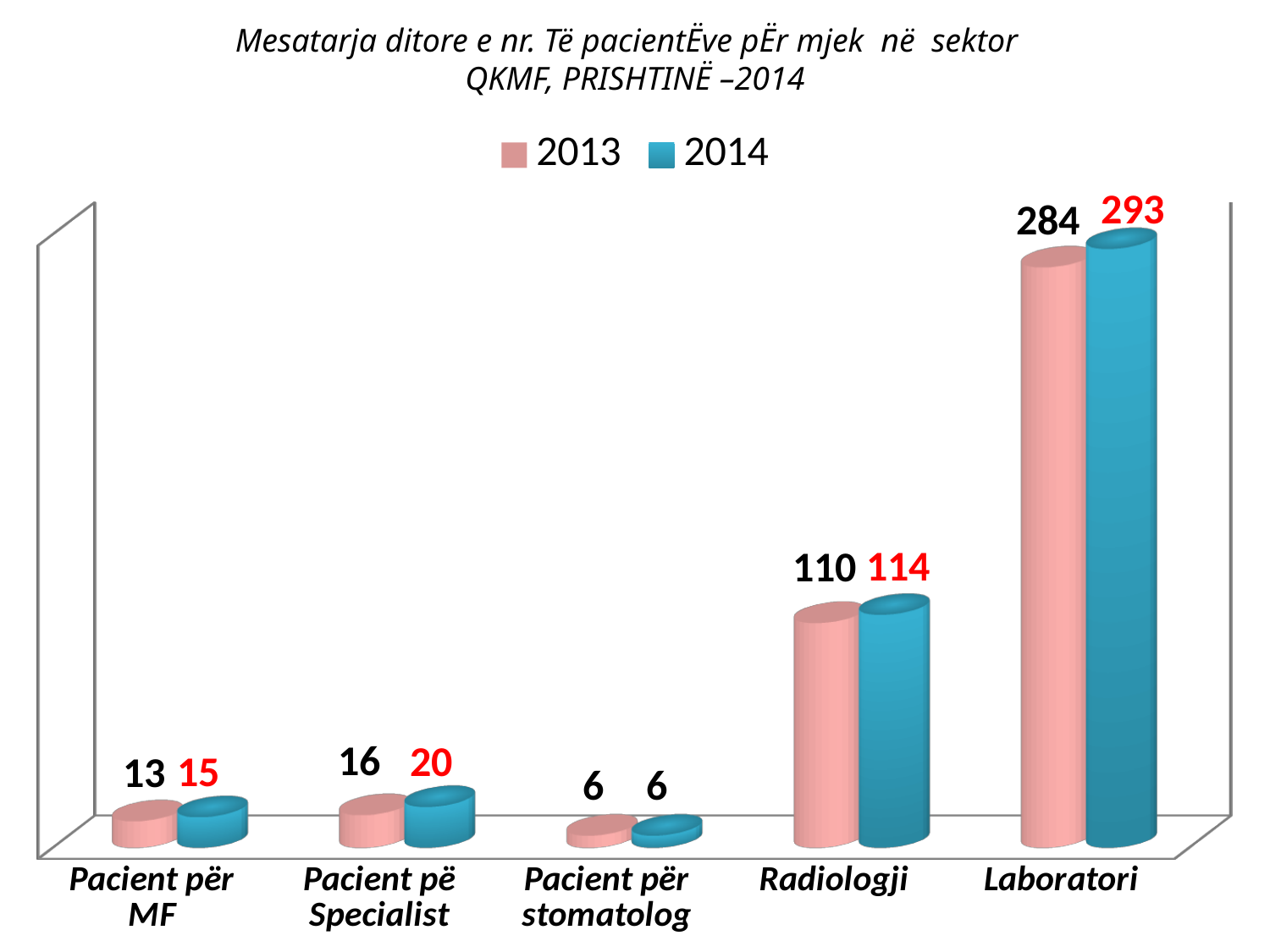
What is the difference between the 2014 and 2013 values for Pacient pë Specialist? 4 What is the 2014 value for Pacient për MF? 15 How many categories are shown on the x axis? 5 How many series does the legend list? 2 Which is larger for Radiologji, the 2013 value or the 2014 value? 2014 Which category has the lowest 2013 value? Pacient për stomatolog What is the difference between the 2014 and 2013 values for Laboratori? 9 What kind of chart is shown on the slide? Bar chart Which category has the highest 2014 value? Laboratori What is the 2013 value for Radiologji? 110 What is the 2014 value for Laboratori? 293 What is the 2013 value for Pacient për stomatolog? 6